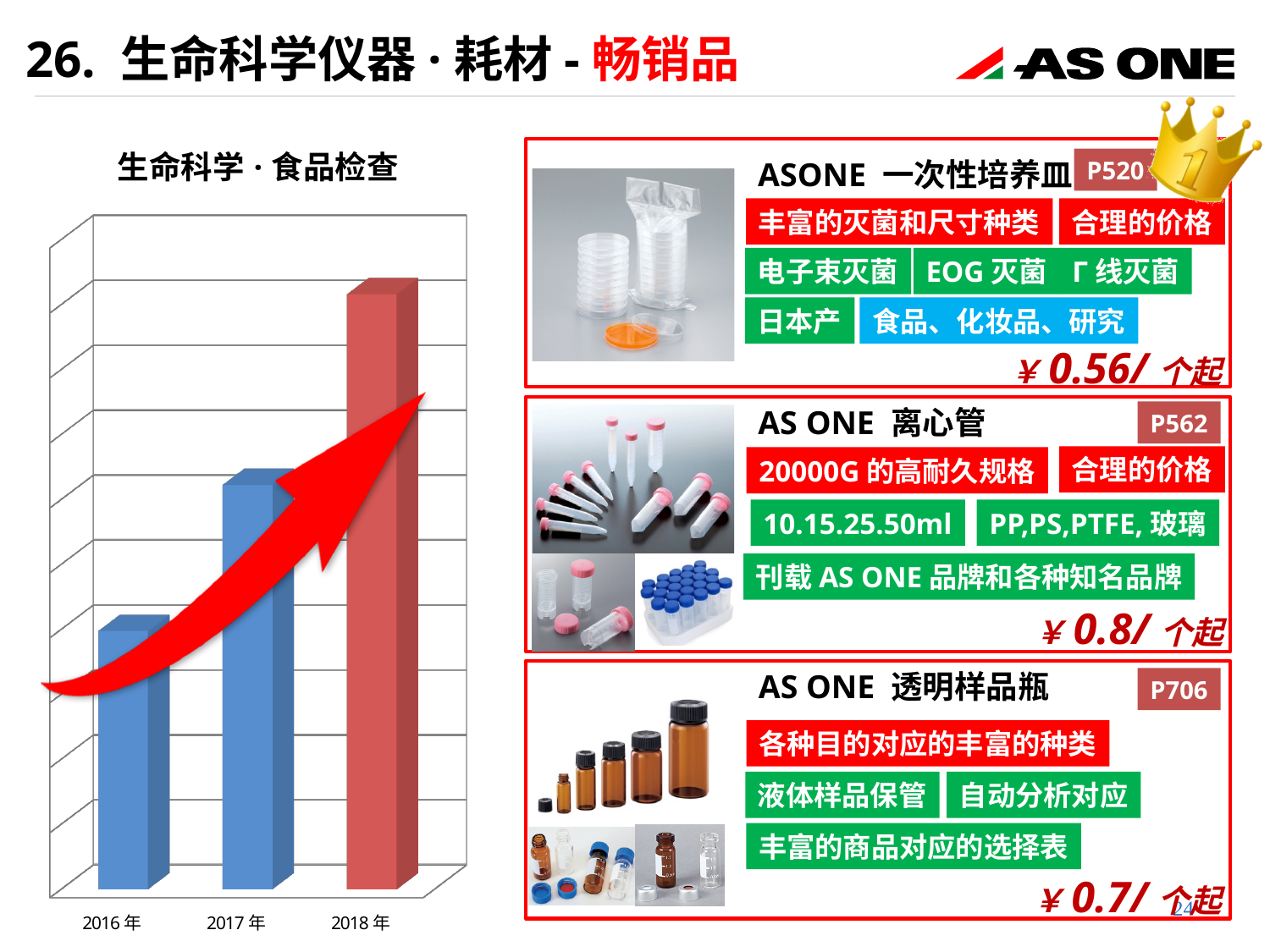
What kind of chart is shown on the left of the slide? bar chart Do the bar values rise or fall from 2016年 to 2018年? rise Which year has the highest bar in the chart? 2018年 What is the label of the first category on the x axis of the chart? 2016年 Which bar is taller, 2017年 or 2018年? 2018年 What colour is the bar for 2018年 in the chart? red What is the title of the chart on the left of the slide? 生命科学·食品检查 Which year has the lowest bar in the chart? 2016年 Which bar is taller, 2016年 or 2017年? 2017年 How many categories are plotted on the x axis of the chart? 3